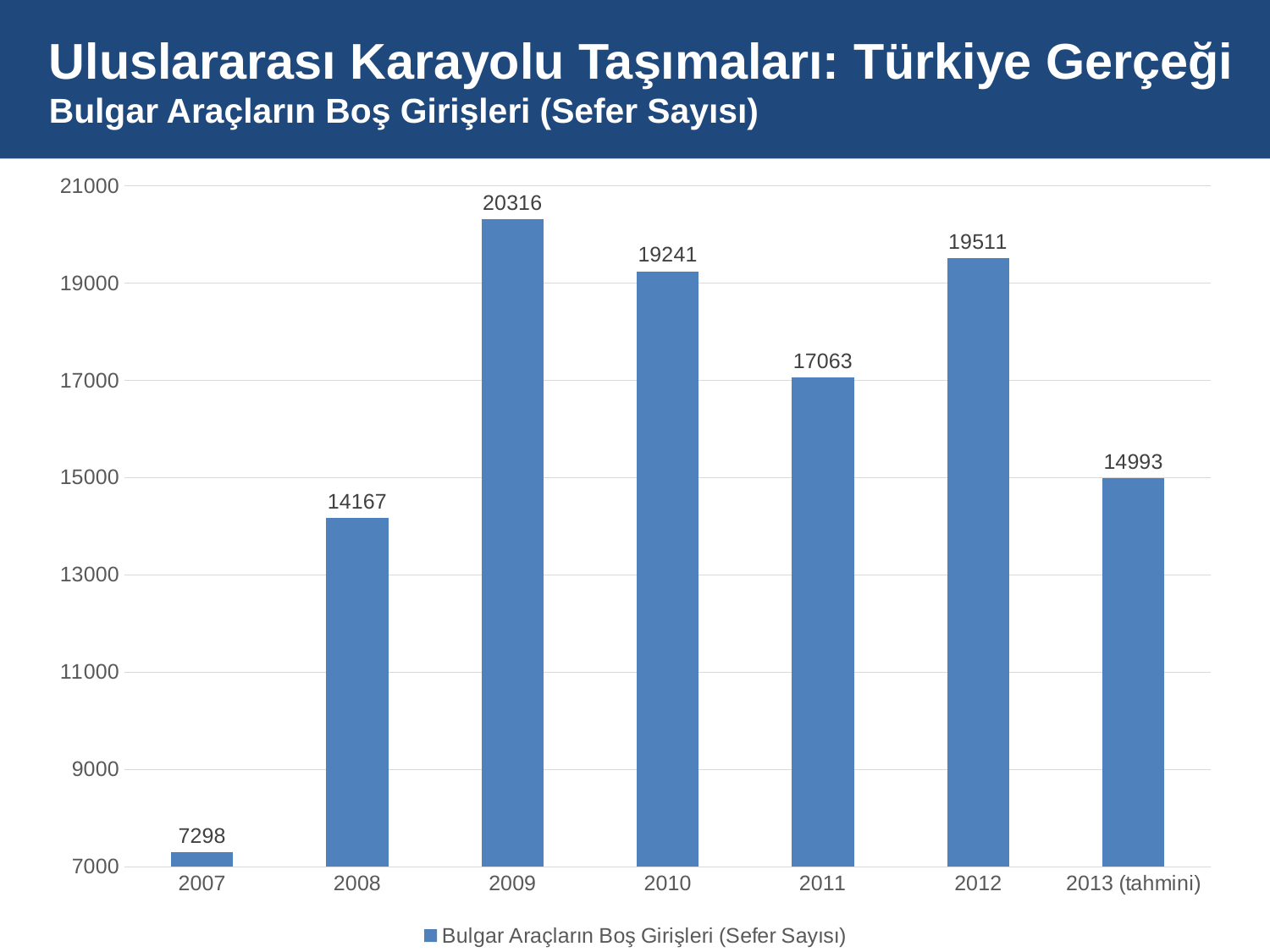
Which year has the lowest value? 2007 What is the difference between the values for 2009 and 2010? 1075 How many years are shown on the x axis? 7 What kind of chart is shown on the slide? bar chart What is the value for 2013 (tahmini)? 14993 What is the value for 2009? 20316 What is the difference between the values for 2012 and 2011? 2448 Is the value for 2008 greater or less than 15000? less Which year has the highest value? 2009 What is the value for 2007? 7298 Which is larger, the value for 2010 or the value for 2012? 2012 What is the legend entry for the series? Bulgar Araçların Boş Girişleri (Sefer Sayısı)